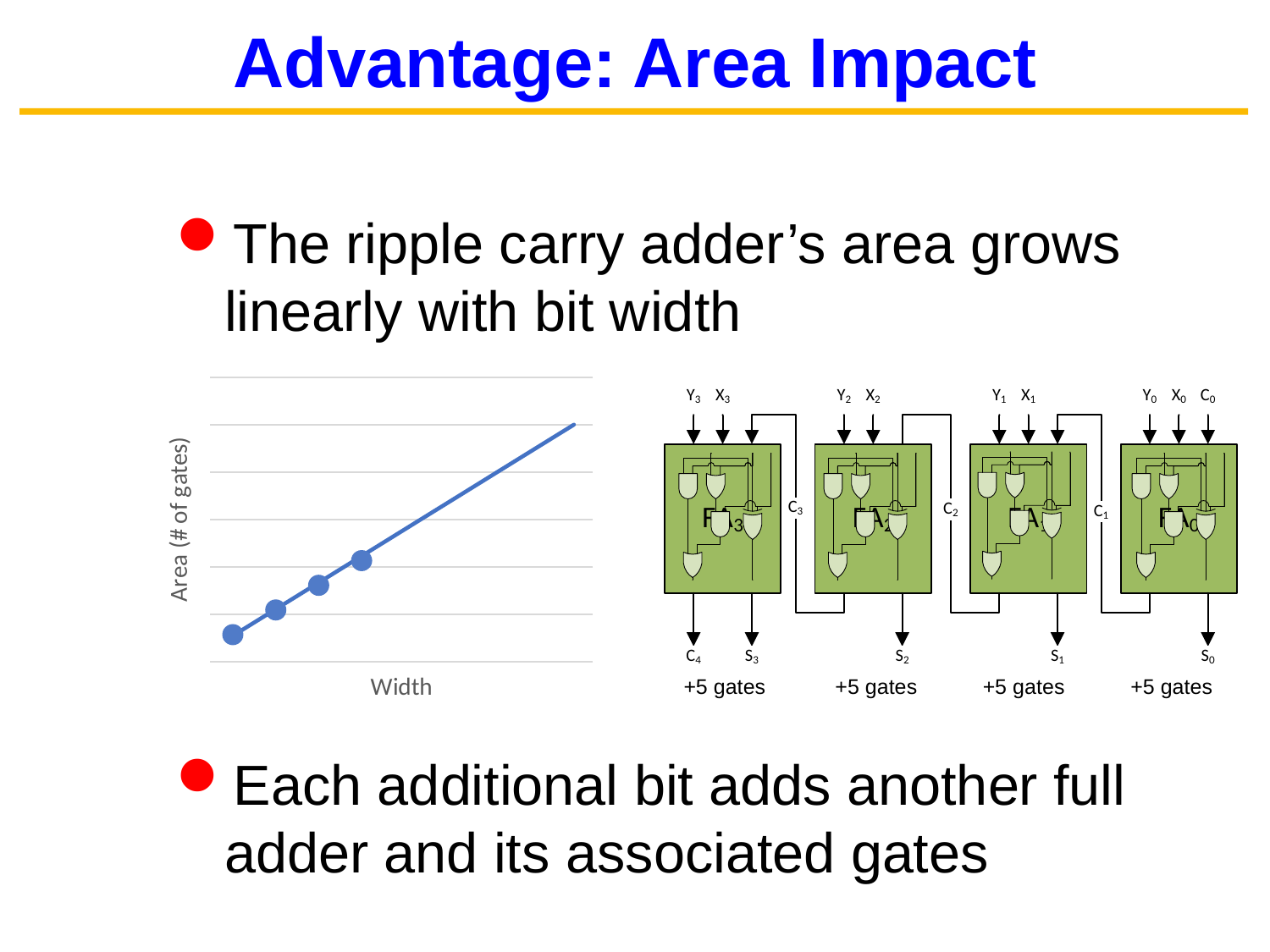
Do the plotted values rise or fall as width increases along the x axis? rise How many data points are marked on the line in the chart? 4 What is the label of the vertical axis of the chart? Area (# of gates) What is the label of the horizontal axis of the chart? Width What kind of chart is shown on the slide? line chart